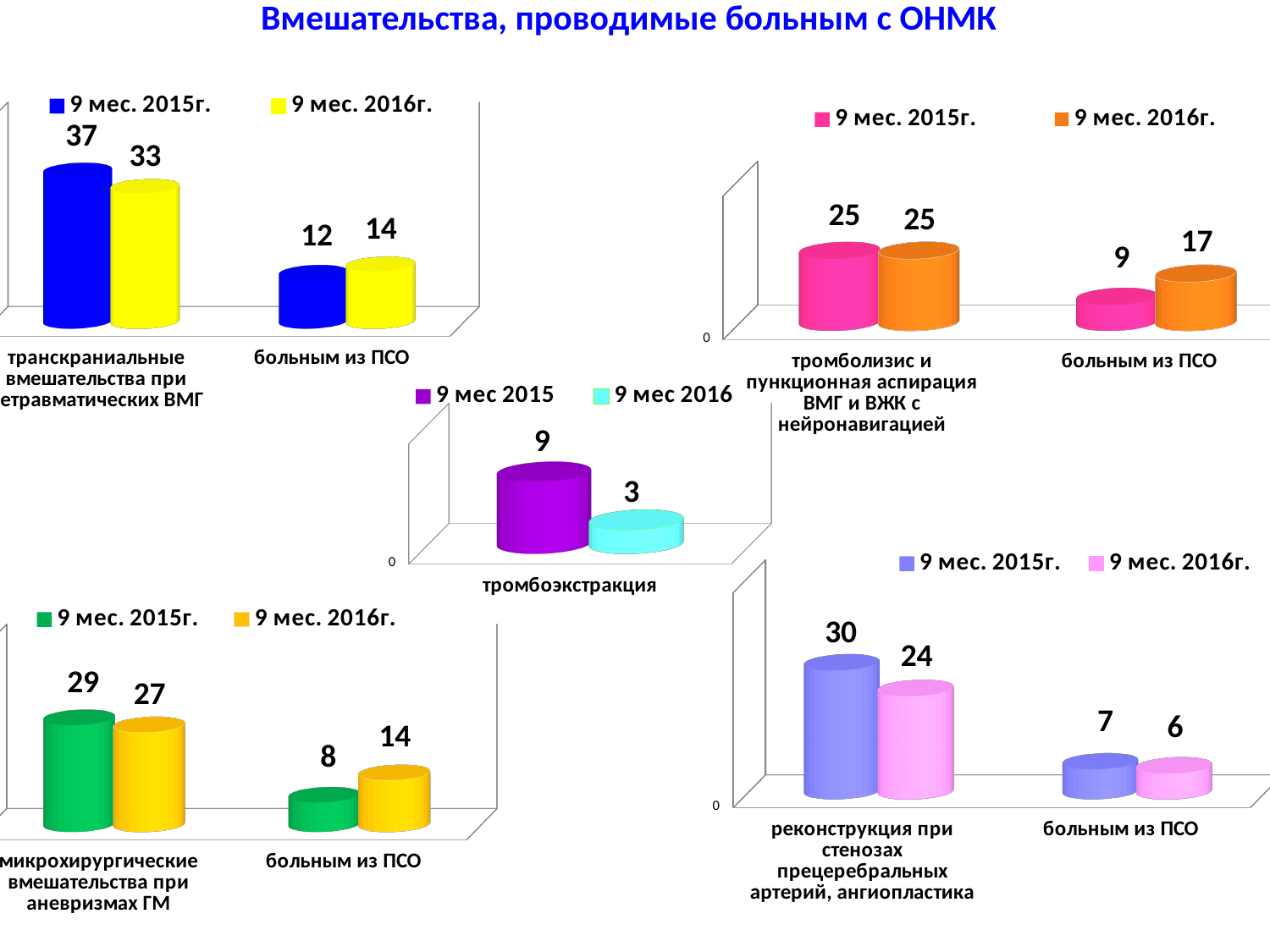
What type of chart is the center chart (тромбоэкстракция)? Bar chart How many series does the legend of the top-right chart list? 2 In the center chart (тромбоэкстракция), which series has the larger value, 9 мес 2015 or 9 мес 2016? 9 мес 2015 In the top-right chart, what is the difference between the 9 мес. 2016г. and 9 мес. 2015г. values for больным из ПСО? 8 In the top-left chart, what is the value for больным из ПСО for 9 мес. 2016г.? 14 In the bottom-left chart, what is the value for микрохирургические вмешательства при аневризмах ГМ for 9 мес. 2016г.? 27 In the top-left chart, what is the value for транскраниальные вмешательства for 9 мес. 2015г.? 37 In the top-right chart, what is the value for больным из ПСО for 9 мес. 2016г.? 17 In the center chart (тромбоэкстракция), what is the value for 9 мес 2016? 3 In the bottom-right chart, which series has the larger value for больным из ПСО, 9 мес. 2015г. or 9 мес. 2016г.? 9 мес. 2015г. In the bottom-right chart, what is the value for реконструкция при стенозах прецеребральных артерий, ангиопластика for 9 мес. 2015г.? 30 In the bottom-left chart, what is the difference between the 9 мес. 2016г. and 9 мес. 2015г. values for больным из ПСО? 6